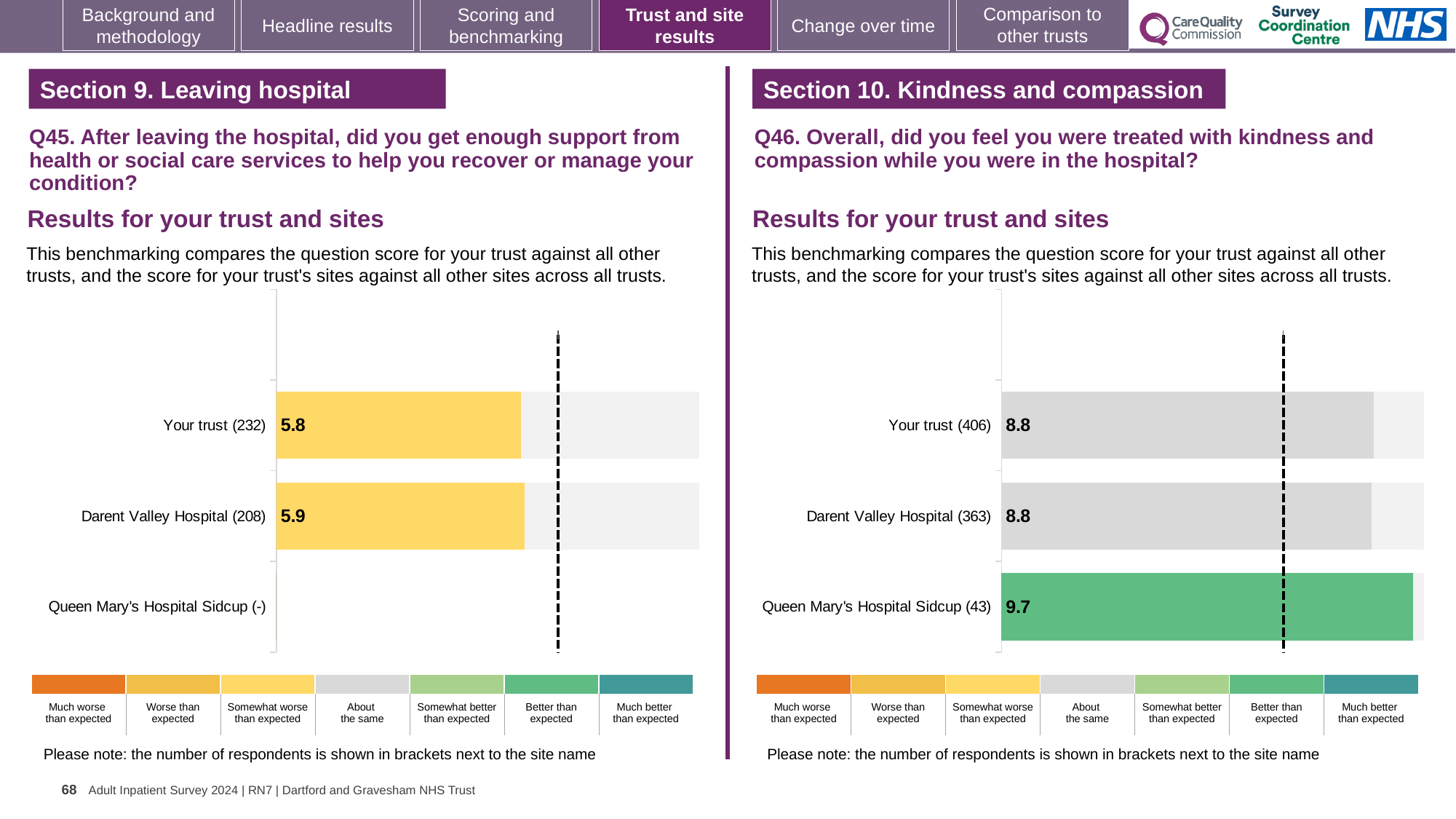
In the Q45 chart on the left, what is the score for Your trust? 5.8 In the Q45 chart on the left, what is the score for Darent Valley Hospital? 5.9 In the Q45 chart on the left, how many respondents are shown for Your trust? 232 In the Q46 chart on the right, what is the difference between the score for Queen Mary's Hospital Sidcup and the score for Your trust? 0.9 In the Q46 chart on the right, which benchmark category does the green bar for Queen Mary's Hospital Sidcup correspond to in the legend? Better than expected In the Q46 chart on the right, which site has the highest score? Queen Mary's Hospital Sidcup What kind of chart is used for the Q45 results on the left? Bar chart How many categories (rows) are listed in the Q46 chart on the right? 3 In the Q46 chart on the right, how many respondents are shown for Queen Mary's Hospital Sidcup? 43 In the Q46 chart on the right, what is the score for Darent Valley Hospital? 8.8 In the Q46 chart on the right, what is the score for Queen Mary's Hospital Sidcup? 9.7 In the Q45 chart on the left, which has the higher score, Your trust or Darent Valley Hospital? Darent Valley Hospital